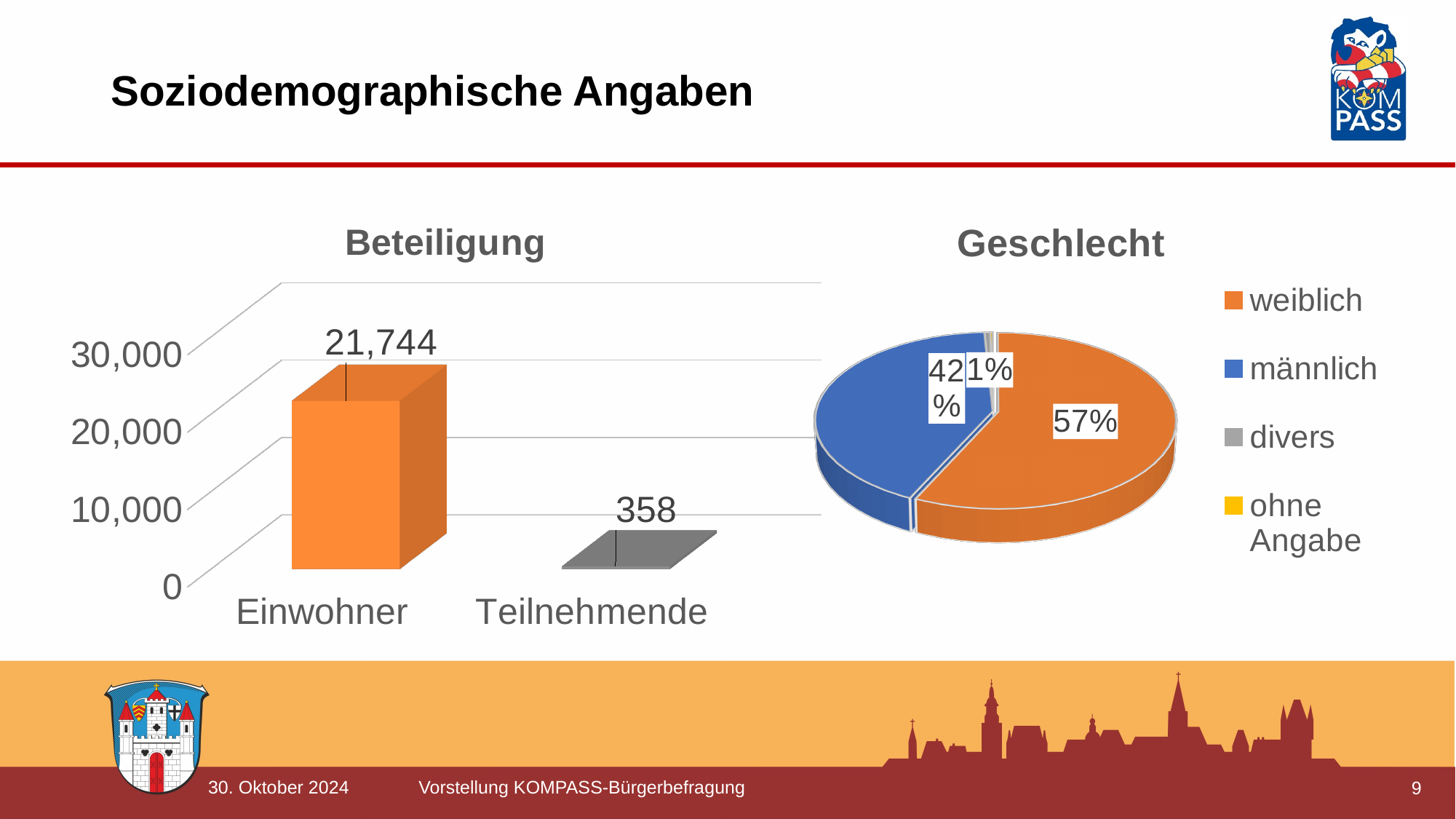
How many entries does the legend of the Geschlecht chart list? 4 How many categories are shown in the Beteiligung chart? 2 In the Beteiligung chart, is the value for Einwohner greater or less than 20,000? greater In the Beteiligung chart, what is the value for Einwohner? 21,744 In the Beteiligung chart, what is the value for Teilnehmende? 358 In the Beteiligung chart, which category has the highest value? Einwohner In the Geschlecht chart, which is larger, weiblich or männlich? weiblich In the Geschlecht chart, what share of the pie is weiblich? 57% In the Beteiligung chart, which category has the lowest value? Teilnehmende In the Geschlecht chart, what share of the pie is männlich? 42% What kind of chart is the Beteiligung chart? bar chart In the Beteiligung chart, what is the difference between the values for Einwohner and Teilnehmende? 21,386